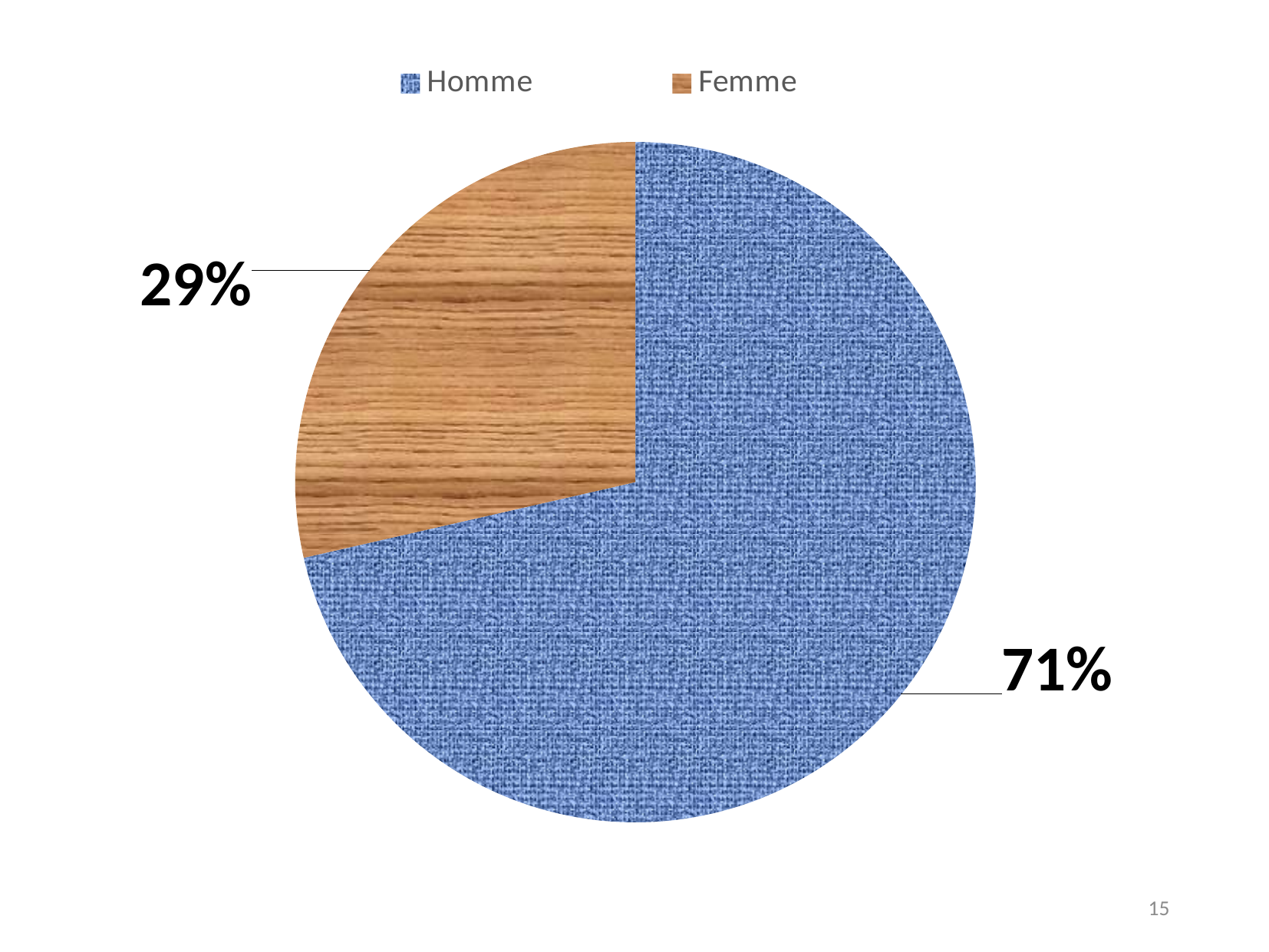
Which category has the smallest slice of the pie? Femme Which category is shown with the blue textured fill? Homme What kind of chart is shown on the slide? pie chart Which category has the largest slice of the pie? Homme What share of the pie does Homme represent? 71% How many entries does the legend list? 2 Which is larger, the Homme slice or the Femme slice? Homme Which category is shown with the wood-grain fill? Femme What share of the pie does Femme represent? 29% What is the difference in percentage points between the Homme and Femme slices? 42 Is the value for Femme greater or less than 50%? less How many categories does the pie chart show? 2